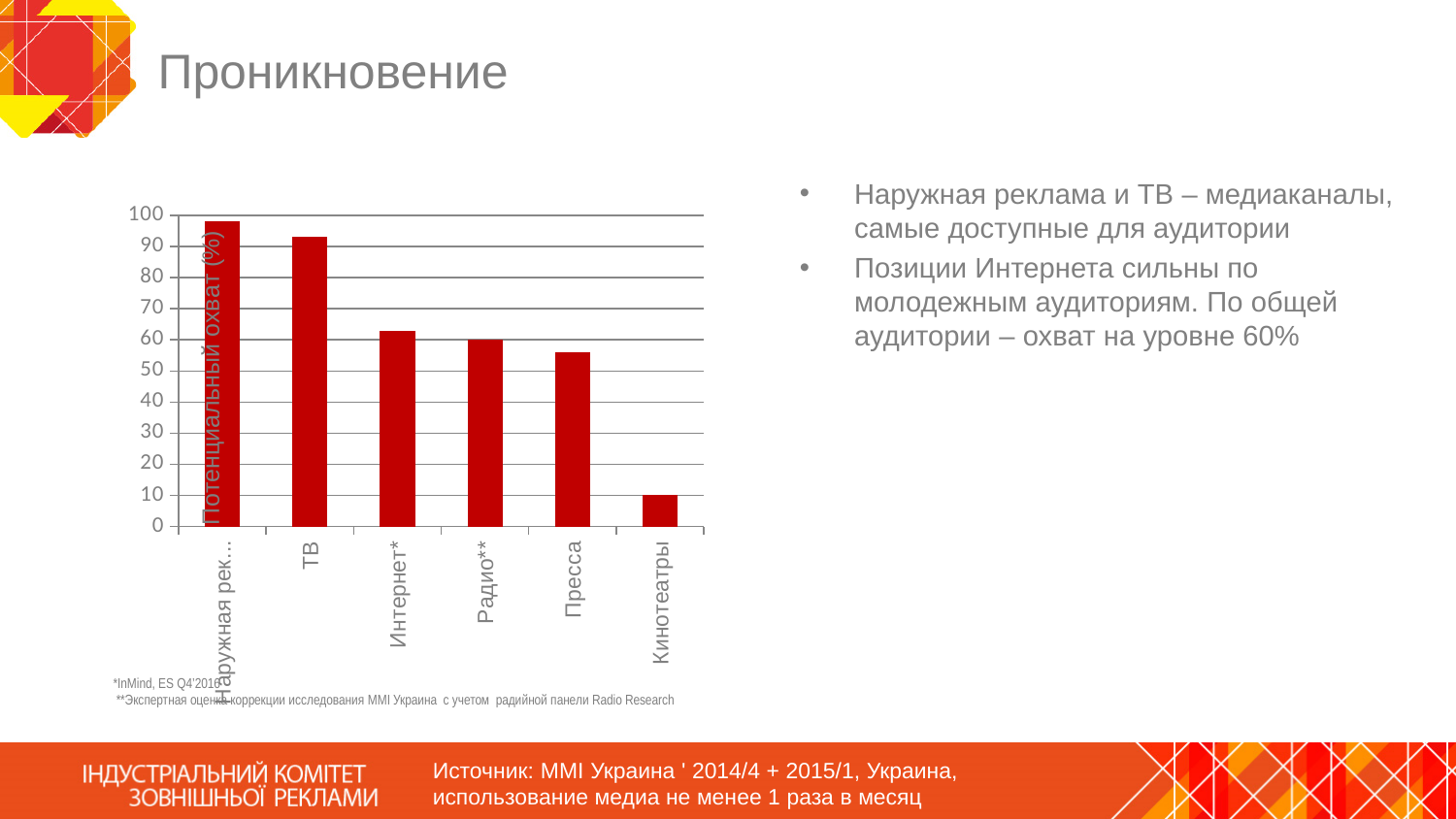
Is the value for Пресса greater or less than 50? greater Is the value for Кинотеатры greater or less than 20? less Which has a larger value, ТВ or Интернет*? ТВ Which category has the highest bar in the chart? Наружная реклама (the first bar) What is the label on the vertical axis of the chart? Потенциальный охват (%) Do the bar values rise or fall from left to right across the categories? fall What kind of chart is shown on the slide? bar chart Which category has the lowest bar in the chart? Кинотеатры Is the value for ТВ greater or less than 90? greater How many categories are plotted in the chart? 6